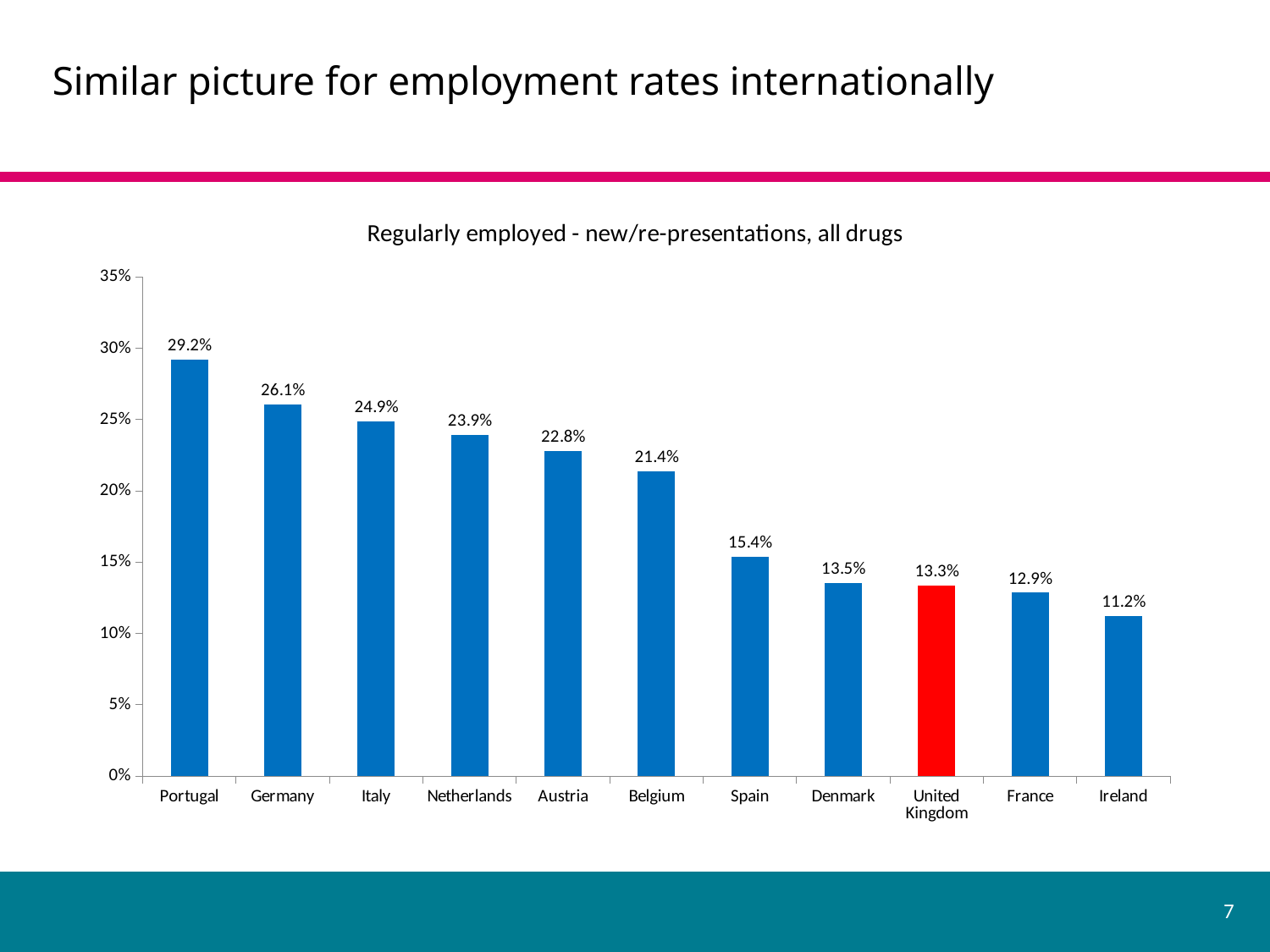
Which has a larger value, Austria or Belgium? Austria What is the value for the United Kingdom? 13.3% What is the difference between the values for Germany and Spain? 10.7% Which country's bar is coloured red? United Kingdom How many countries are shown on the chart? 11 What is the value for Netherlands? 23.9% Which country has the lowest value? Ireland What is the value for Portugal? 29.2% What kind of chart is shown on the slide? bar chart Do the values rise or fall from left to right along the x axis? fall Is the value for Italy greater or less than 20%? greater Which country has the highest value? Portugal